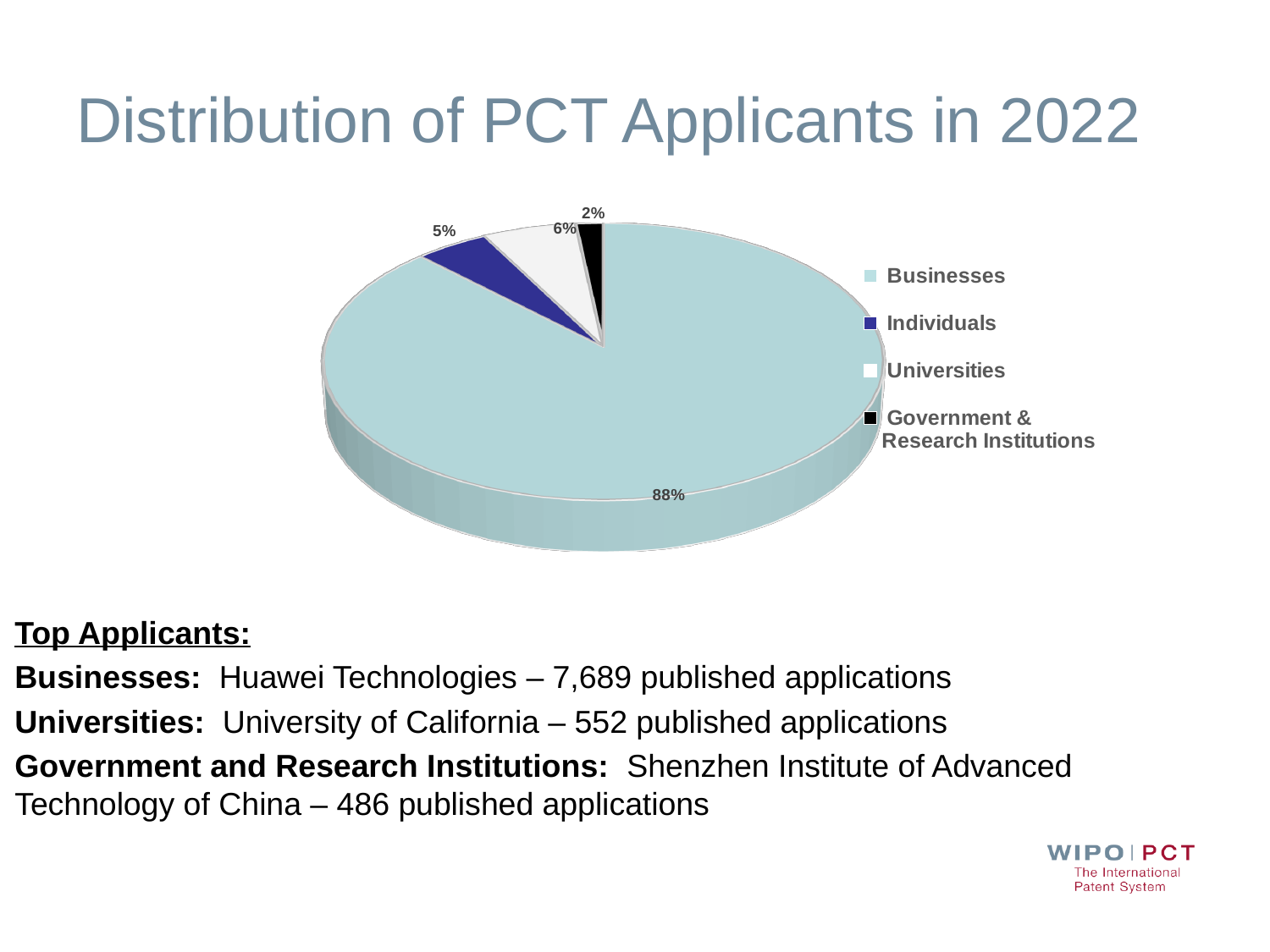
What share of PCT applicants in 2022 were Universities? 6% What is the difference in percentage points between the Businesses share and the Universities share? 82 percentage points Which has a larger share, Individuals or Universities? Universities What share of PCT applicants in 2022 were Businesses? 88% How many categories are shown in the pie chart? 4 What type of chart is shown on the slide? Pie chart Which applicant category has the largest share of the pie? Businesses What is the difference in percentage points between the Universities share and the Individuals share? 1 percentage point Which applicant category has the smallest share of the pie? Government & Research Institutions What share of PCT applicants in 2022 were Government & Research Institutions? 2% What is the title of the chart on the slide? Distribution of PCT Applicants in 2022